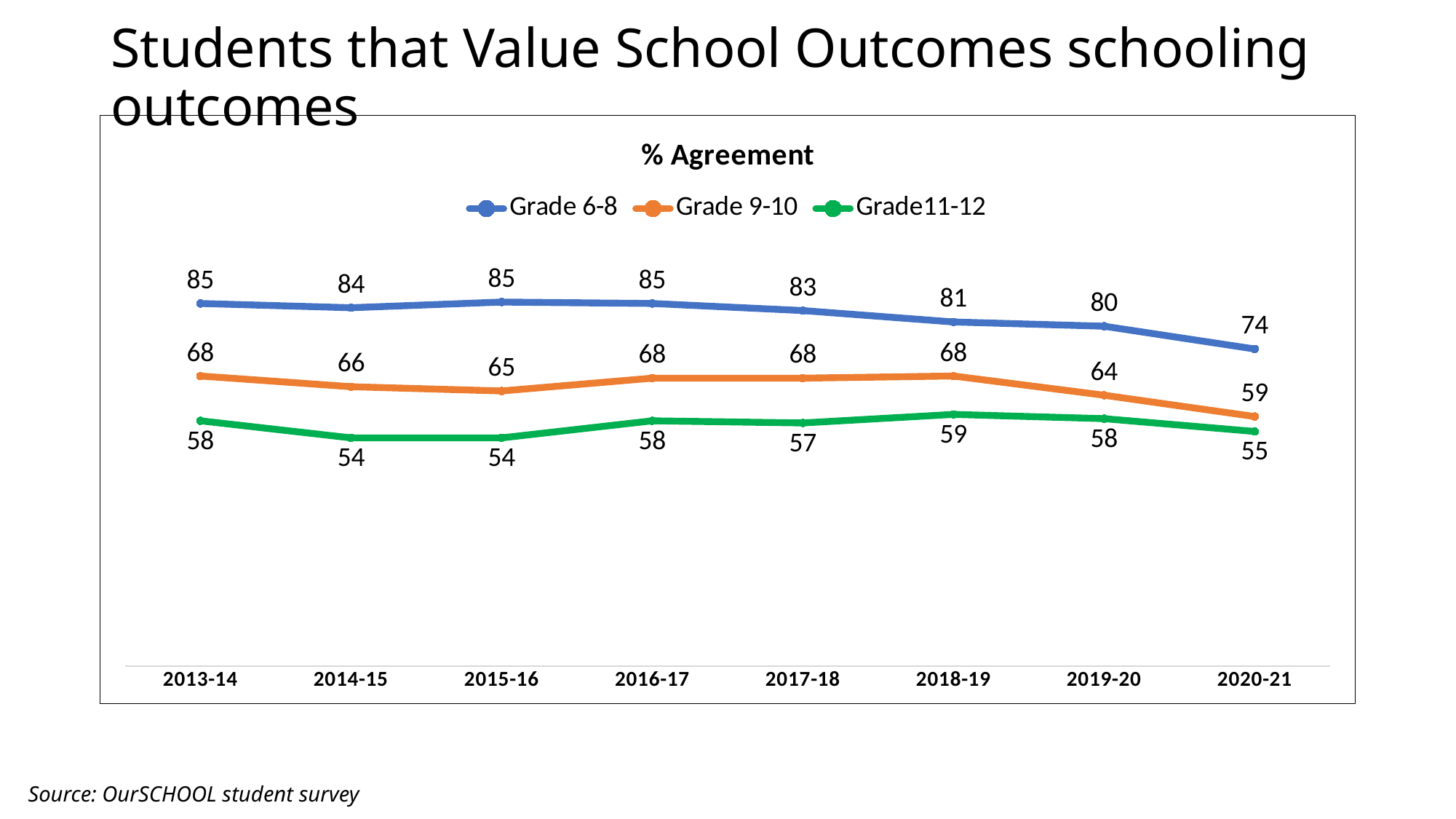
How many years are shown on the x axis? 8 What is the % Agreement value for Grade 6-8 in 2020-21? 74 How many series does the legend list? 3 Which is larger in 2016-17: the Grade 9-10 value or the Grade11-12 value? Grade 9-10 How much did the Grade 6-8 value fall from 2019-20 to 2020-21? 6 In which year is the Grade11-12 value lowest? 2014-15 and 2015-16 What is the % Agreement value for Grade11-12 in 2018-19? 59 What is the % Agreement value for Grade 9-10 in 2019-20? 64 Does the Grade 6-8 series rise or fall from 2016-17 to 2020-21? Fall What is the difference between the Grade 6-8 and Grade11-12 values in 2013-14? 27 What kind of chart is shown on the slide? Line chart In which year is the Grade 9-10 value lowest? 2020-21